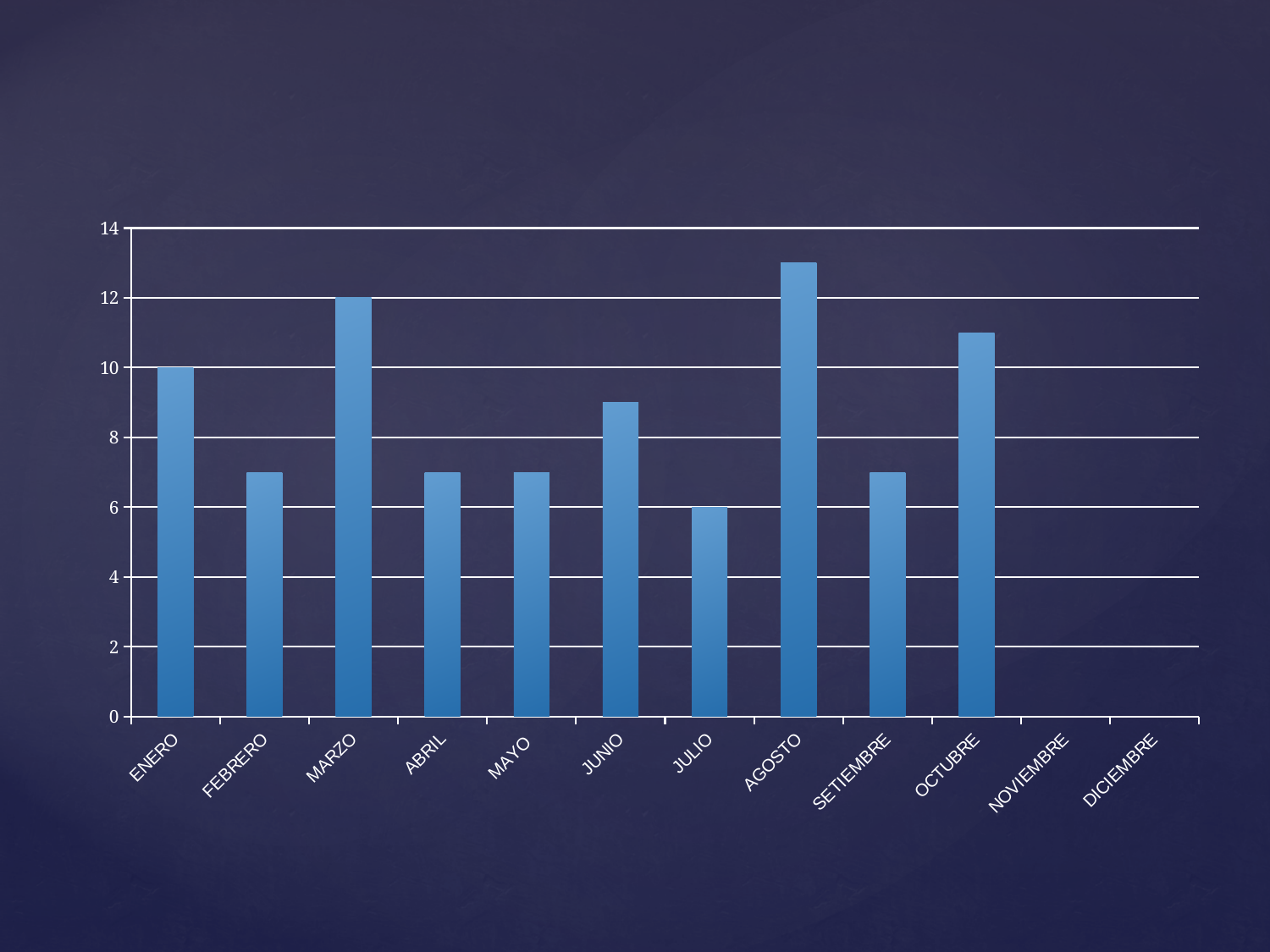
Among the months with a bar, which has the lowest value? JULIO Which month has the highest bar? AGOSTO What is the value for MARZO? 12 What is the value for ENERO? 10 What is the value for JULIO? 6 What kind of chart is shown on the slide? bar chart Is the value for FEBRERO greater or less than 8? less Is the value for AGOSTO greater or less than 12? greater What is the difference between the values for ENERO and JULIO? 4 Which is larger, the value for MARZO or the value for ENERO? MARZO What is the difference between the values for MARZO and ENERO? 2 How many month categories are shown on the x axis? 12